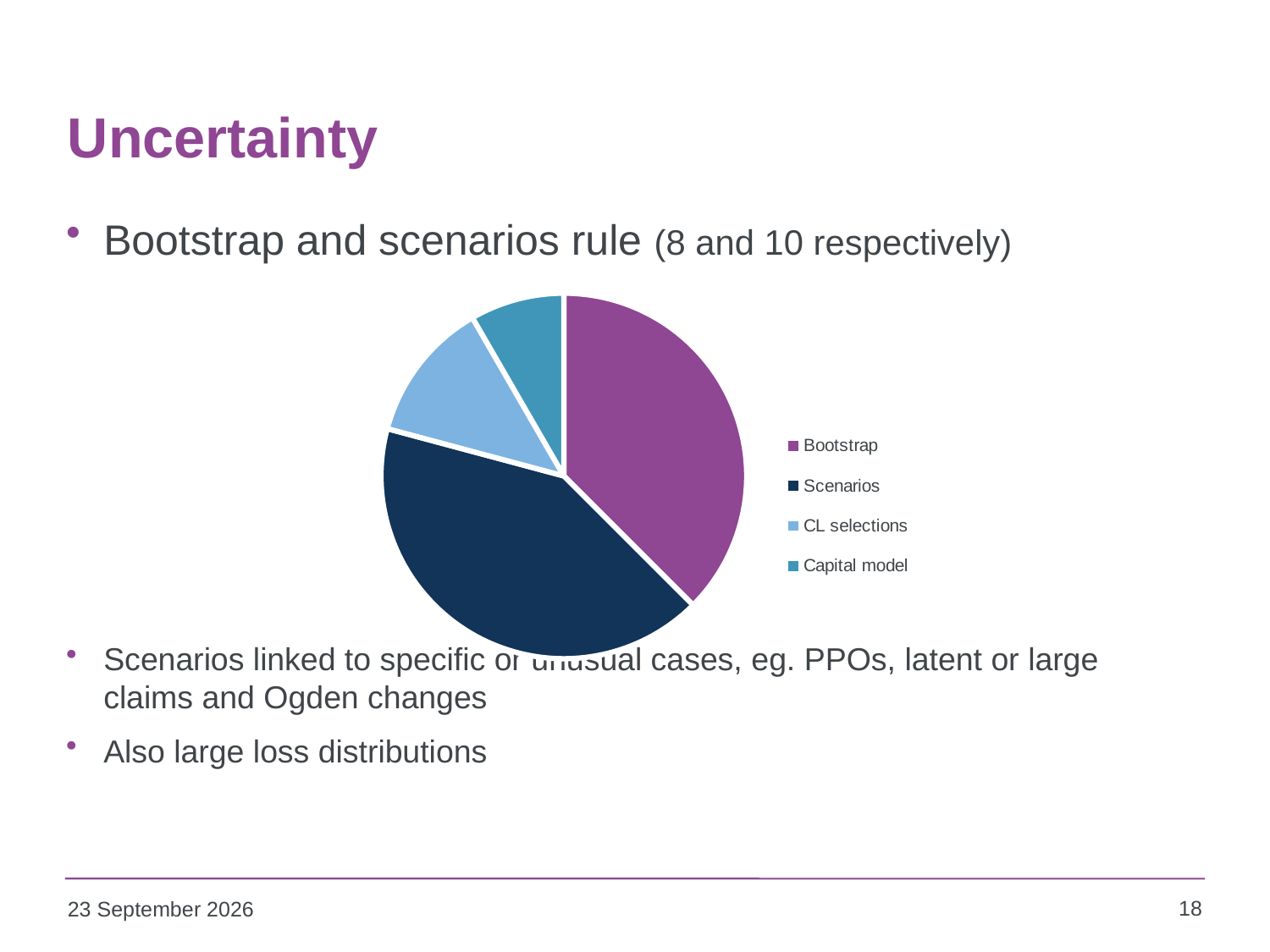
How many slices does the pie chart have? 4 Which category has the largest slice of the pie chart? Scenarios Which slice is larger in the pie chart, Scenarios or Bootstrap? Scenarios How many entries does the legend of the pie chart list? 4 According to the slide, what is the value for Bootstrap? 8 Which slice is larger in the pie chart, Bootstrap or CL selections? Bootstrap What colour is the Bootstrap slice in the pie chart? purple What kind of chart is shown on the slide? pie chart By how much does the value for Scenarios exceed the value for Bootstrap, according to the slide? 2 Which slice is larger in the pie chart, CL selections or Capital model? CL selections According to the slide, what is the value for Scenarios? 10 Which category has the smallest slice of the pie chart? Capital model